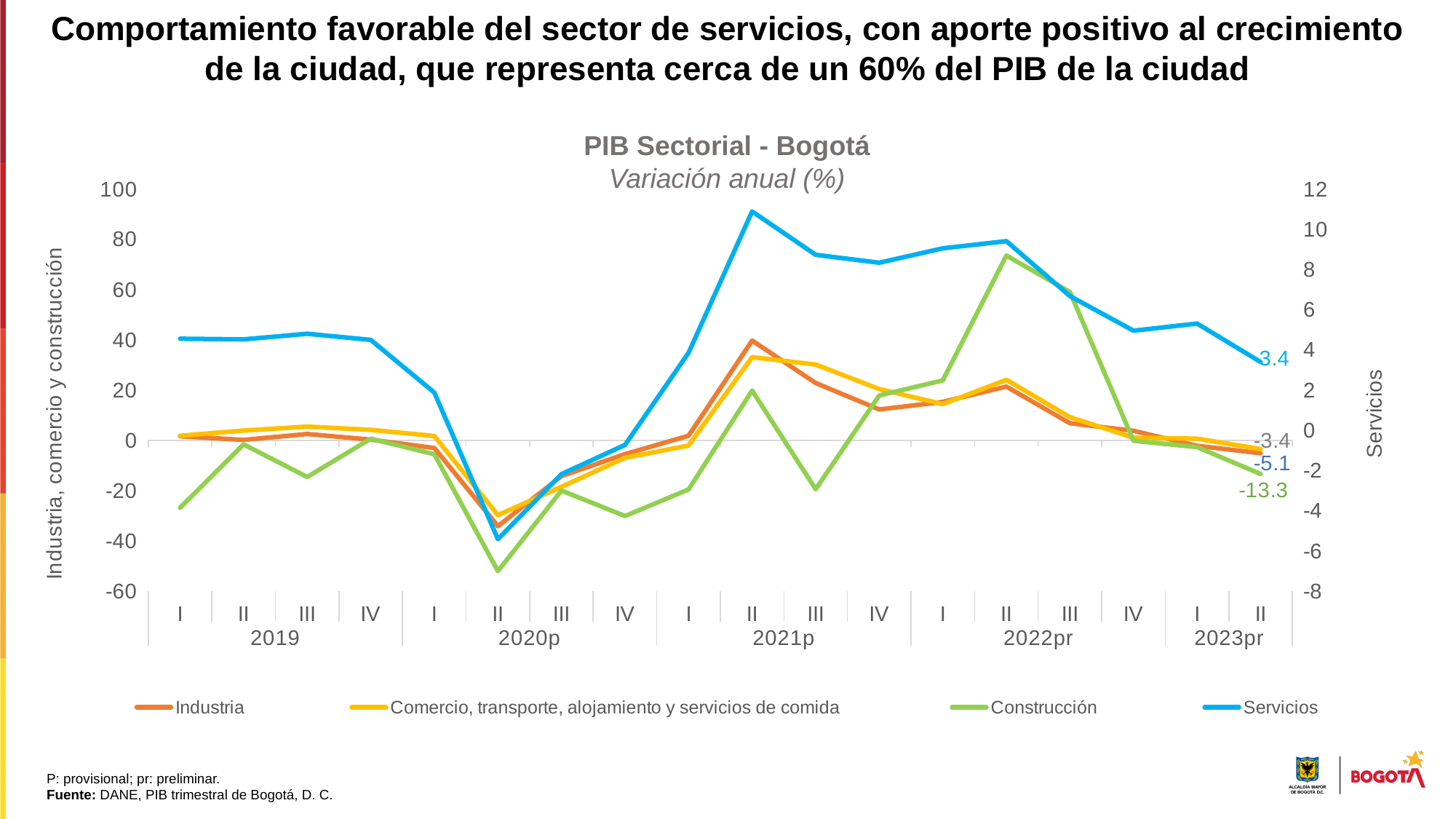
How many series does the legend list? 4 How many quarterly points are plotted along the x axis? 18 What type of chart is shown on the slide? line chart Is the value for Construcción in 2022pr II greater or less than 60? greater What is the value for Comercio, transporte, alojamiento y servicios de comida in 2023pr II? -3.4 What is the difference between the Industria and Construcción values in 2023pr II? 8.2 Which series has the lowest value in 2023pr II? Construcción In 2023pr II, which is larger: the value for Industria or the value for Construcción? Industria What is the value for Servicios in 2023pr II? 3.4 What is the value for Construcción in 2023pr II? -13.3 What is the title of the chart? PIB Sectorial - Bogotá What is the value for Industria in 2023pr II? -5.1